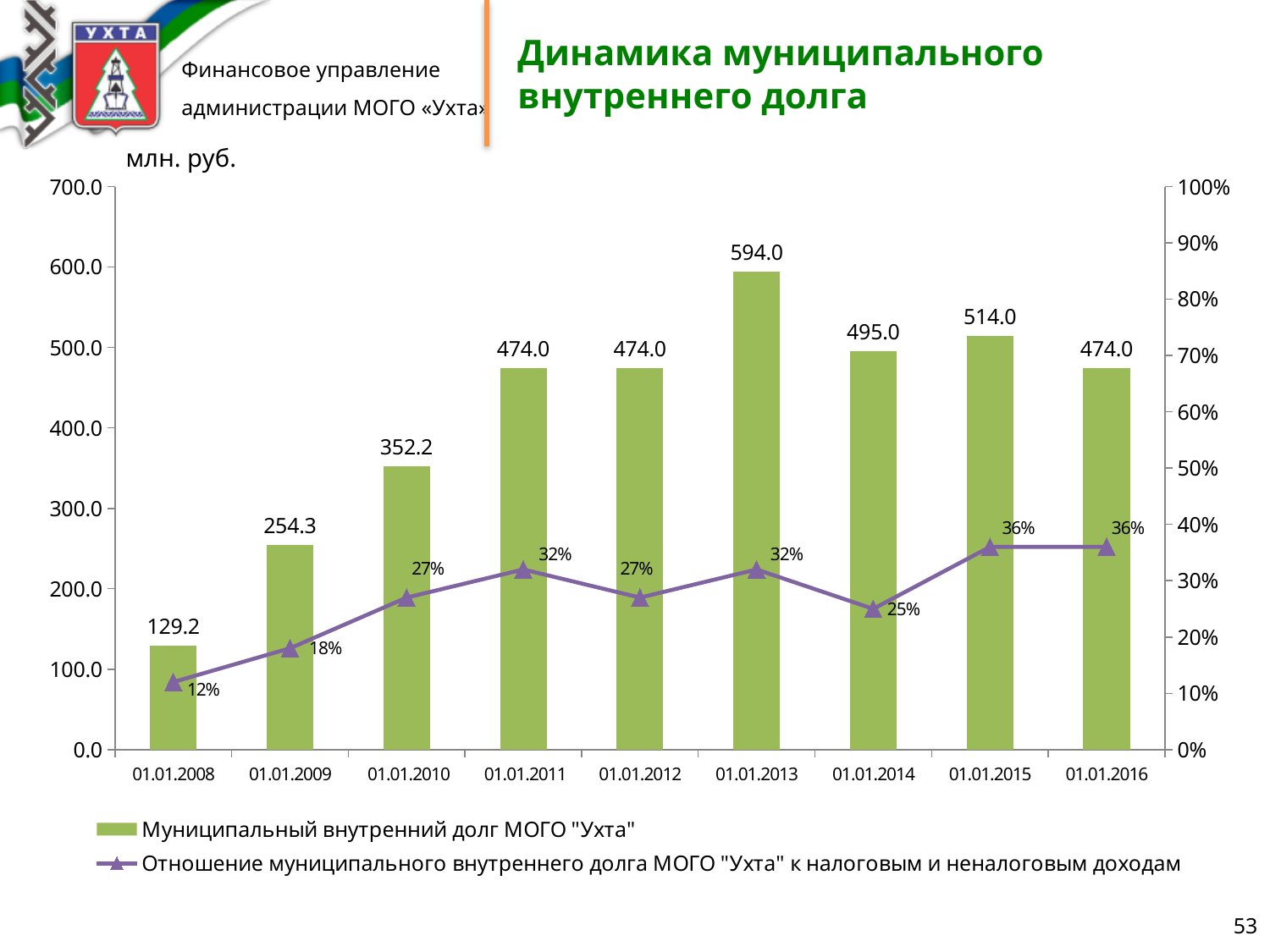
What is the difference between the municipal internal debt on 01.01.2013 and on 01.01.2014? 99.0 What is the municipal internal debt of MOGO "Ukhta" on 01.01.2013? 594.0 What unit is indicated above the left axis of the chart? млн. руб. How many series does the legend list? 2 What kind of chart is used to show the municipal internal debt of MOGO "Ukhta"? bar chart On which date is the municipal internal debt lowest? 01.01.2008 On which date is the municipal internal debt highest? 01.01.2013 Does the ratio of municipal internal debt to tax and non-tax revenues rise or fall from 01.01.2008 to 01.01.2011? rise What is the ratio of municipal internal debt to tax and non-tax revenues on 01.01.2014? 25% How many dates are shown on the x axis of the chart? 9 Which is larger, the municipal internal debt on 01.01.2015 or on 01.01.2016? 01.01.2015 What is the municipal internal debt of MOGO "Ukhta" on 01.01.2008? 129.2